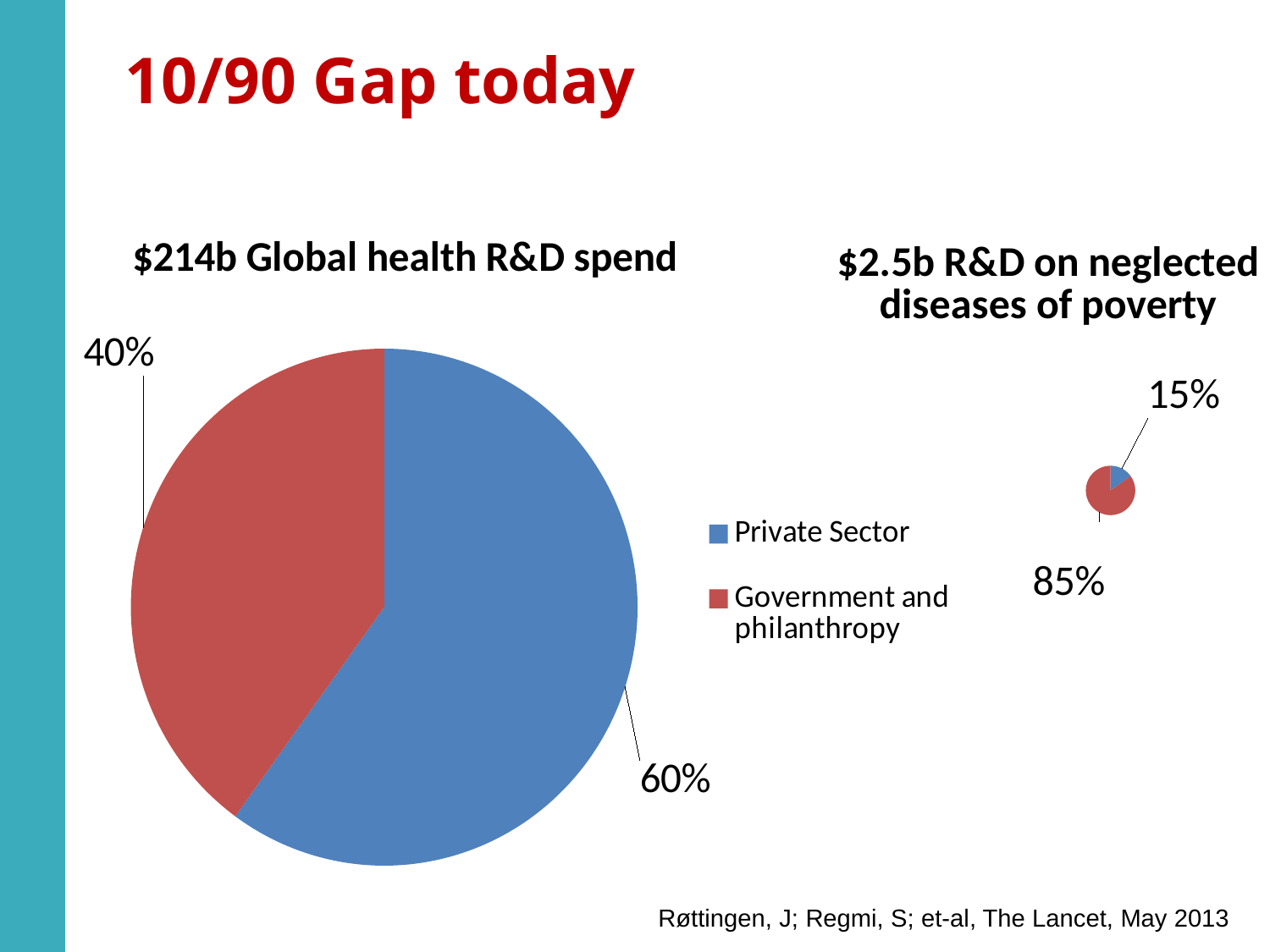
In the "$2.5b R&D on neglected diseases of poverty" chart, what is the difference in percentage points between the Government and philanthropy and Private Sector slices? 70 percentage points In the "$214b Global health R&D spend" chart, which slice is the largest? Private Sector Which colour represents Government and philanthropy in the legend? Red In the "$214b Global health R&D spend" chart, what share does the Private Sector have? 60% In the "$2.5b R&D on neglected diseases of poverty" chart, which slice is the smallest? Private Sector In the "$2.5b R&D on neglected diseases of poverty" chart, what share does Government and philanthropy have? 85% Which chart has the larger Private Sector share, "$214b Global health R&D spend" or "$2.5b R&D on neglected diseases of poverty"? $214b Global health R&D spend What kind of chart is the "$214b Global health R&D spend" chart? Pie chart In the "$2.5b R&D on neglected diseases of poverty" chart, what share does the Private Sector have? 15% In the "$214b Global health R&D spend" chart, what is the difference in percentage points between the Private Sector and Government and philanthropy slices? 20 percentage points How many slices does the "$2.5b R&D on neglected diseases of poverty" pie chart have? 2